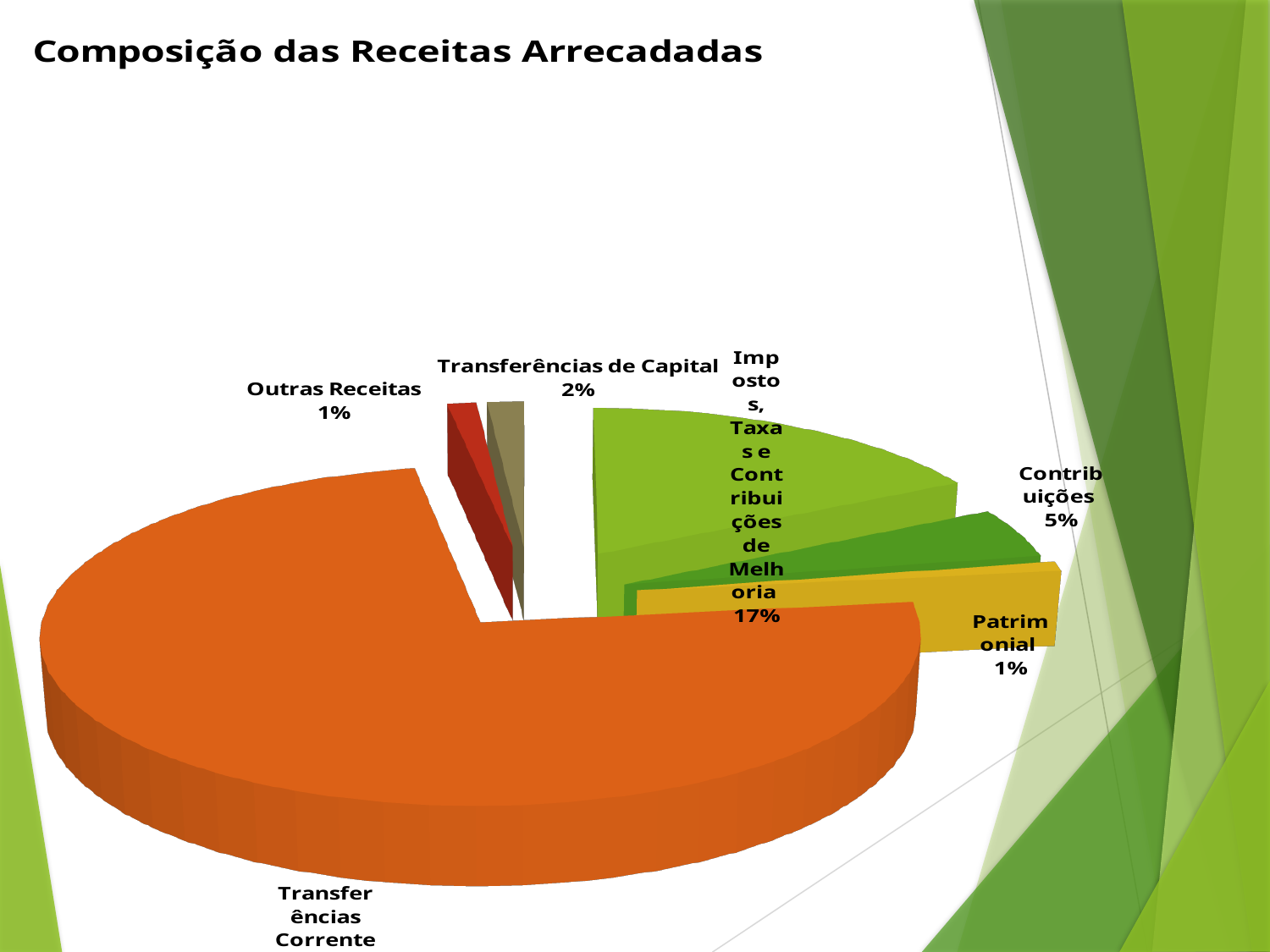
What percentage is shown for Transferências de Capital? 2% What is the difference in percentage points between Impostos, Taxas e Contribuições de Melhoria and Contribuições? 12 percentage points How many slices does the pie chart have? 6 What is the title of the chart? Composição das Receitas Arrecadadas What percentage is shown for Patrimonial? 1% What percentage is shown for Outras Receitas? 1% Which is larger, Patrimonial or Transferências de Capital? Transferências de Capital Which is larger, Contribuições or Transferências de Capital? Contribuições What kind of chart is shown on the slide? Pie chart What percentage is shown for Contribuições? 5% What share of the pie does Impostos, Taxas e Contribuições de Melhoria represent? 17% Which slice of the pie is the largest? Transferências Corrente